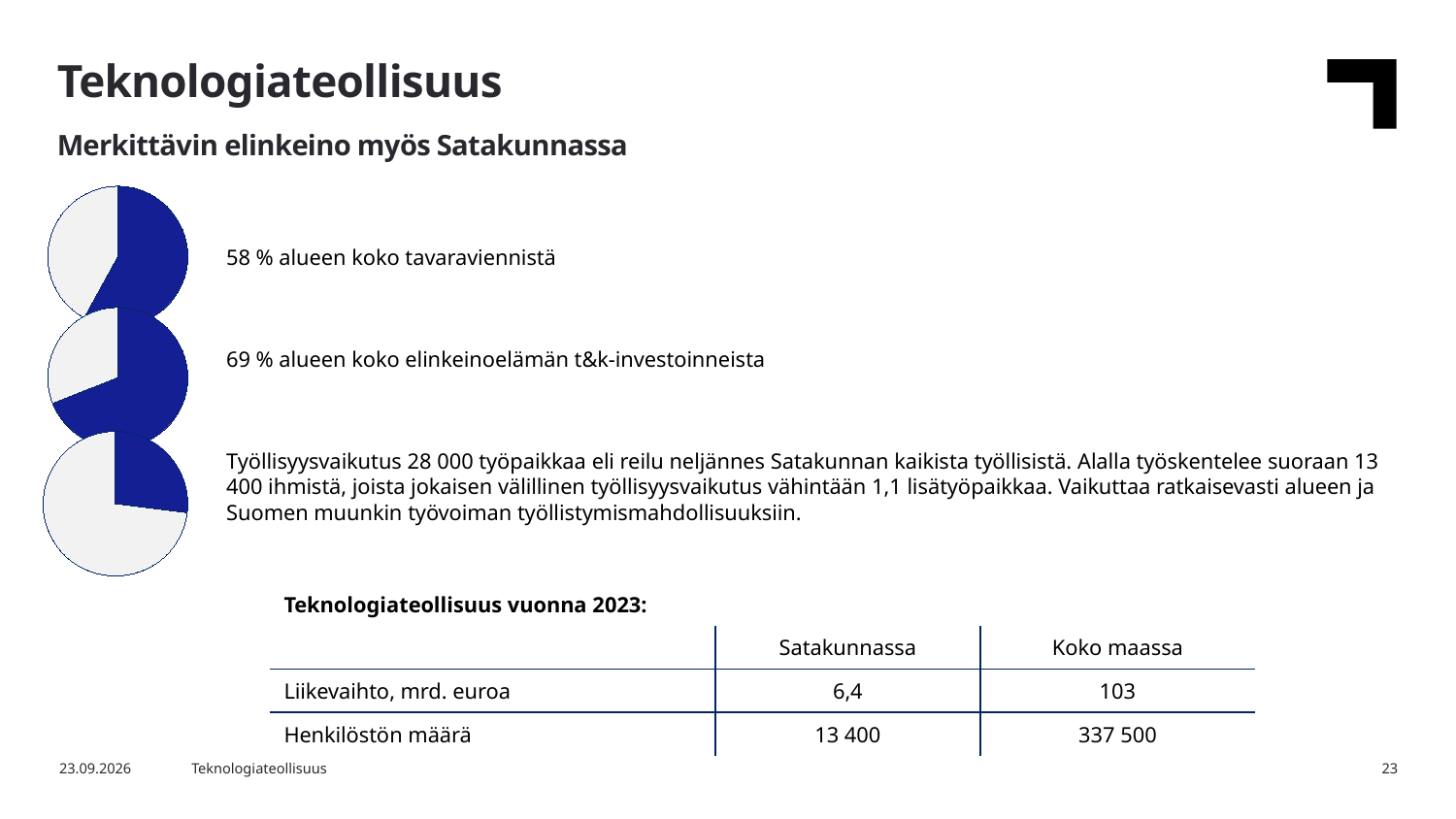
What does the blue slice of the top pie chart represent, according to the text next to it? 58 % alueen koko tavaraviennistä What colour is used for the highlighted slice in each pie chart? Blue How many pie charts are on the slide? 3 In the top pie chart, what share of the region's total goods exports does the blue slice represent? 58 % Which of the three pie charts has the smallest blue slice? The bottom pie chart Is the blue slice in the bottom pie chart greater or less than half of the pie? less What is the difference in percentage points between the share shown by the middle pie chart (69 %) and the top pie chart (58 %)? 11 percentage points Which pie chart has the larger blue slice, the top one (goods exports) or the middle one (R&D investments)? The middle one (R&D investments) Which of the three pie charts has the largest blue slice? The middle pie chart (69 %) What kind of charts are shown on the left side of the slide? Pie charts In the middle pie chart, what share of the region's business R&D investments does the blue slice represent? 69 %